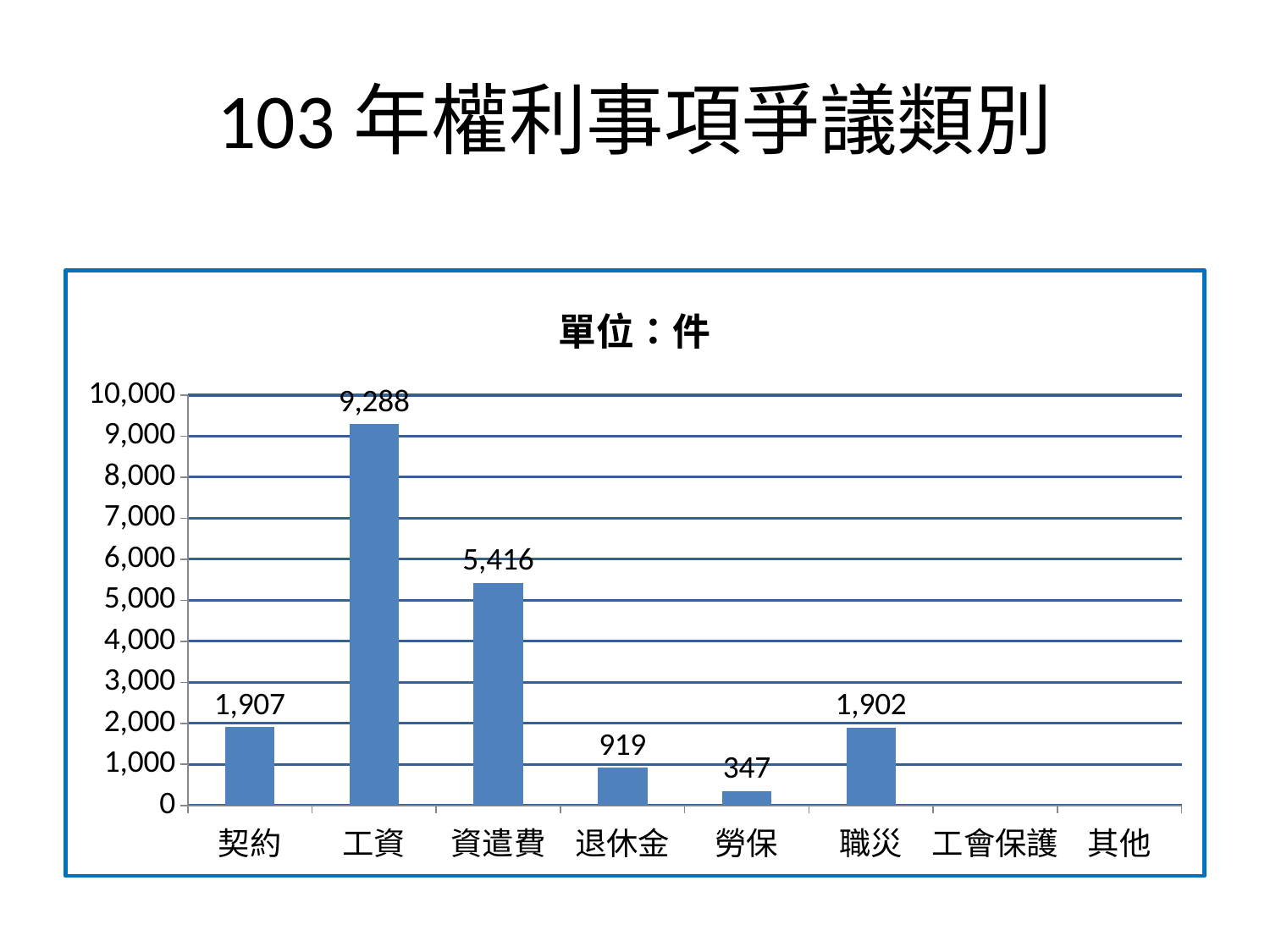
What is the value for 工資? 9,288 Is the value for 退休金 greater or less than 1,000? less What is the difference between the values for 退休金 and 勞保? 572 Which category has the highest value? 工資 What is the difference between the values for 工資 and 資遣費? 3,872 What is the value for 資遣費? 5,416 Which is larger, the value for 資遣費 or the value for 職災? 資遣費 How many categories are labeled on the x axis? 8 What kind of chart is shown on the slide? bar chart What is the value for 勞保? 347 What is the value for 職災? 1,902 What is the title shown above the chart area? 單位：件